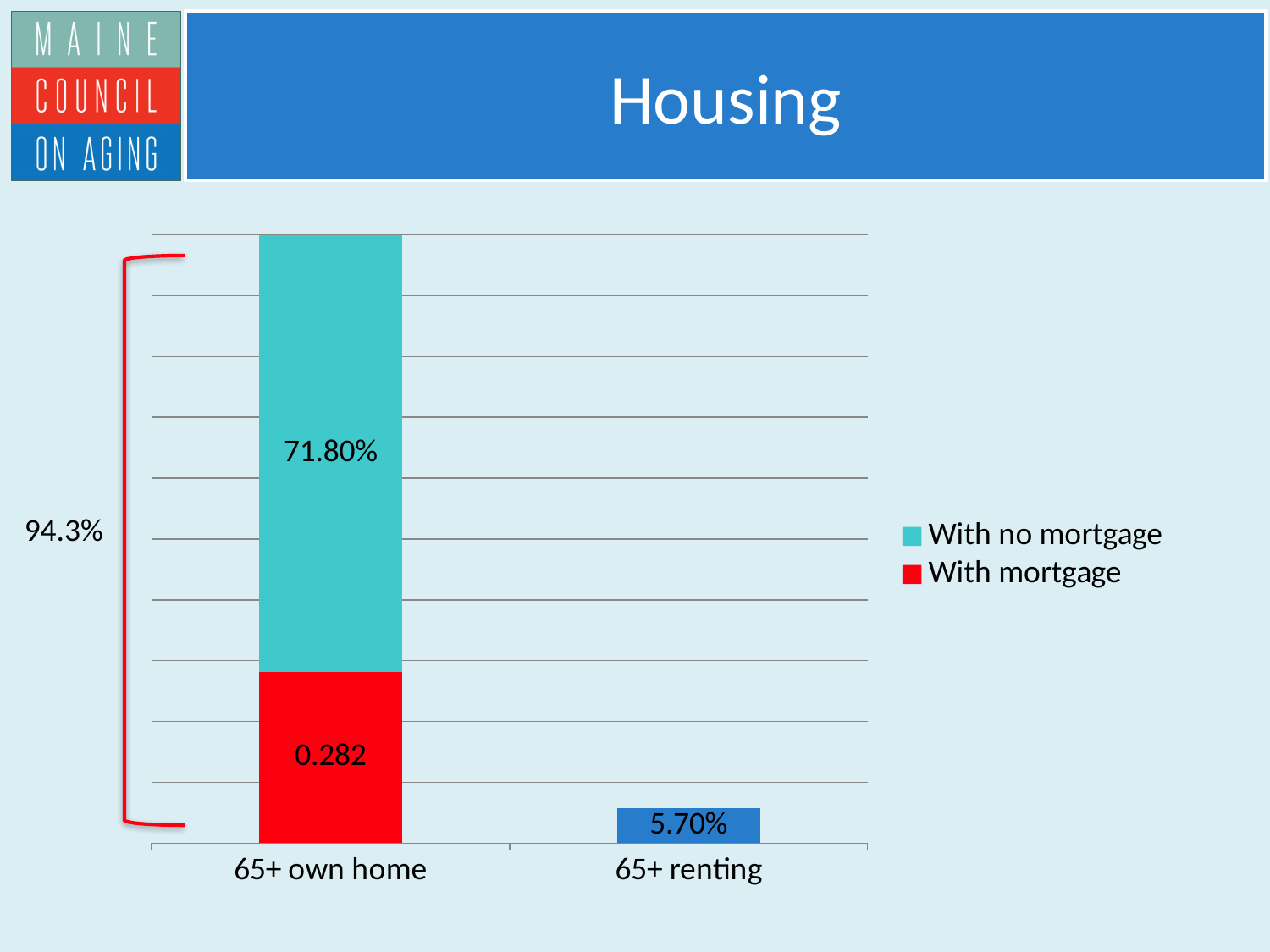
Which category has the lowest bar? 65+ renting Which segment of the '65+ own home' bar is larger, 'With no mortgage' or 'With mortgage'? With no mortgage What are the two legend entries? With no mortgage, With mortgage What value is labelled on the bar for '65+ renting'? 5.70% What percentage is written next to the red bracket on the left of the chart? 94.3% What kind of chart is shown on the slide? bar chart Which category has the taller bar, '65+ own home' or '65+ renting'? 65+ own home What is the value of the 'With mortgage' segment for '65+ own home'? 0.282 How many categories are shown on the x axis? 2 What is the value of the 'With no mortgage' segment for '65+ own home'? 71.80% What is the title of the slide? Housing How many series does the legend list? 2